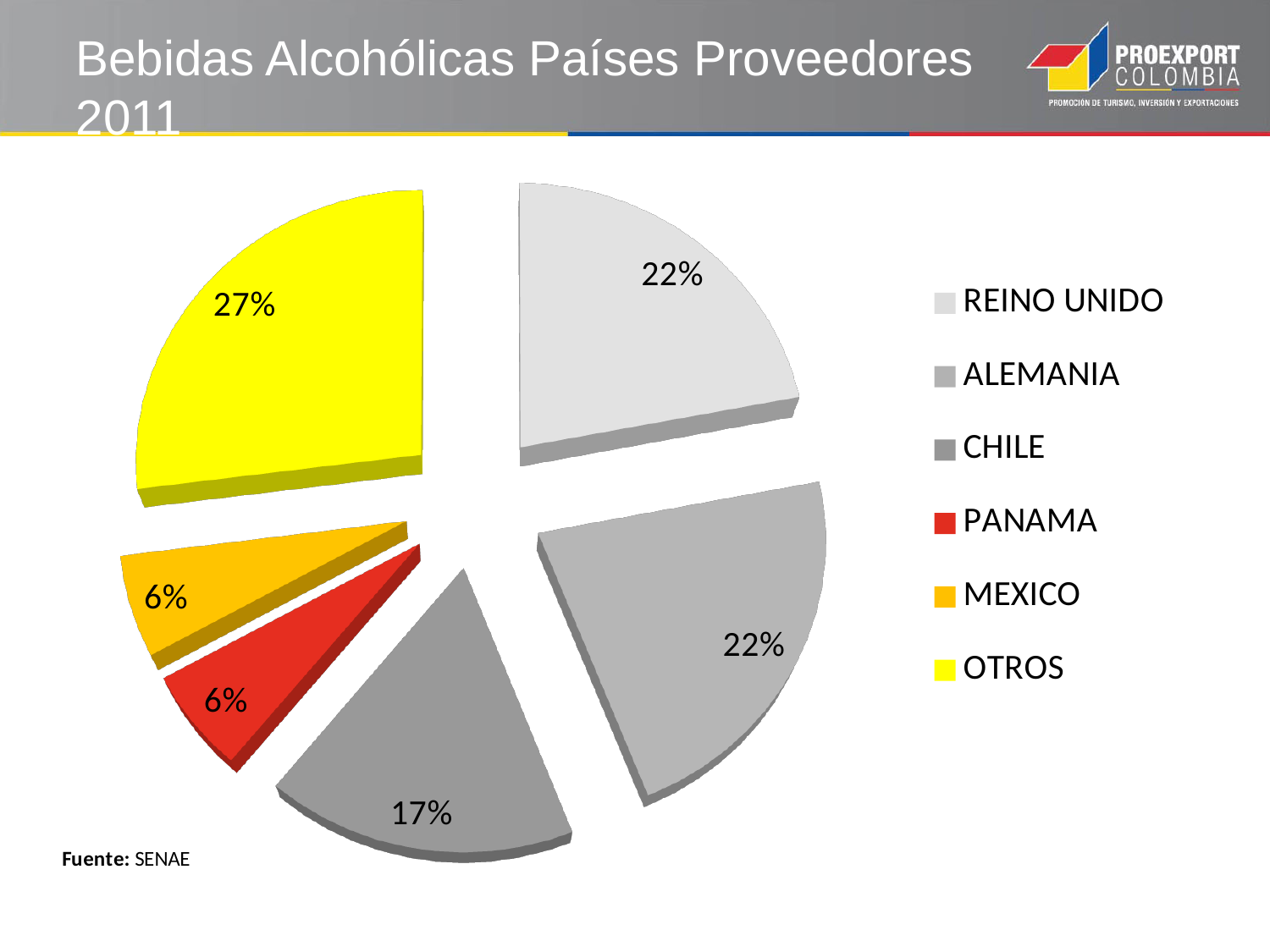
Which category has the largest slice of the pie? OTROS What is the value shown for PANAMA? 6% What kind of chart is shown on the slide? pie chart What share of the pie does REINO UNIDO hold? 22% Which is larger, the slice for CHILE or the slice for MEXICO? CHILE What is the value shown for OTROS? 27% What is the value shown for ALEMANIA? 22% What is the value shown for CHILE? 17% How many categories does the legend list? 6 What is the difference in percentage points between OTROS and CHILE? 10 What colour is the slice for PANAMA? red What is the title of the slide containing the chart? Bebidas Alcohólicas Países Proveedores 2011